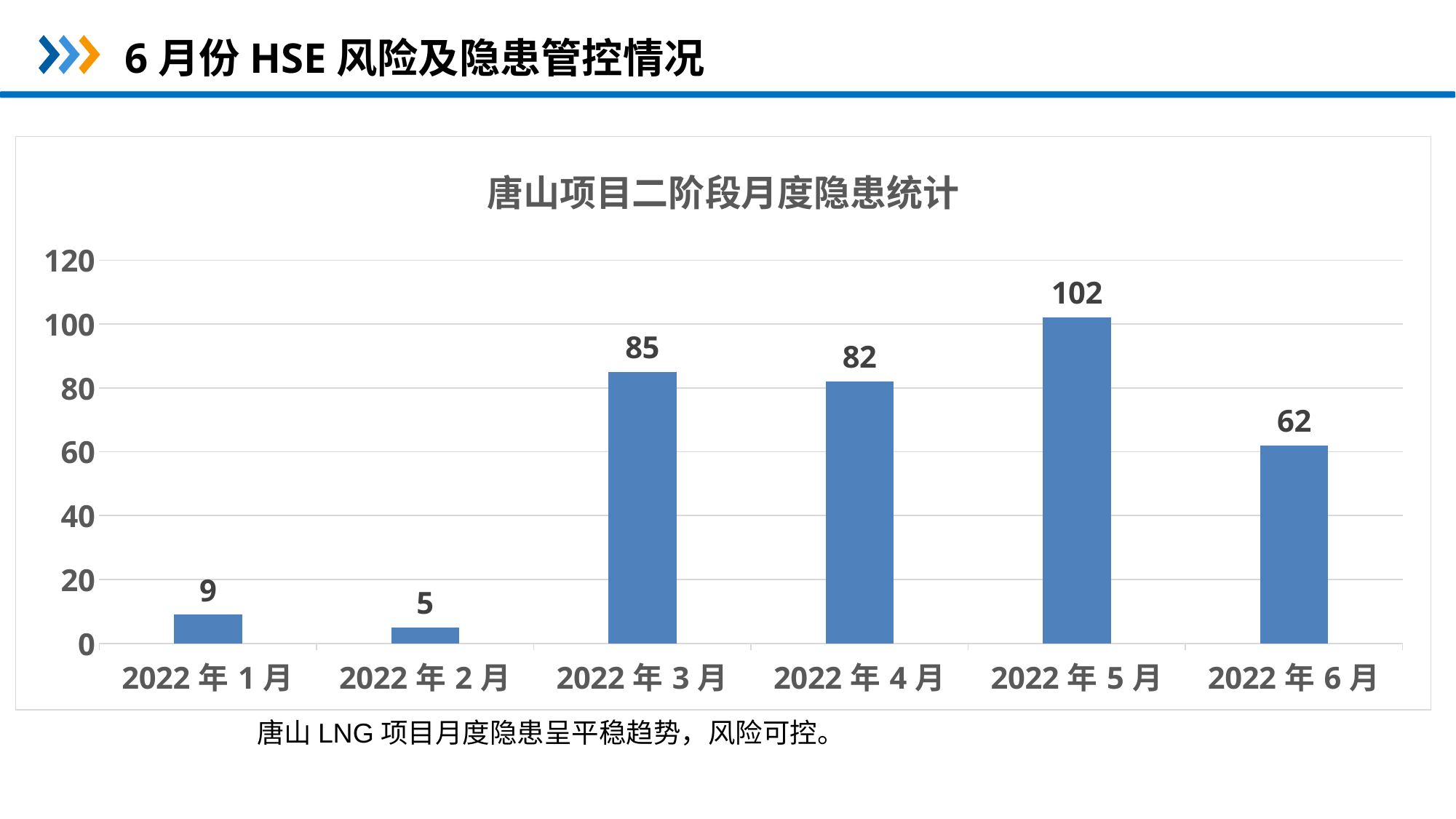
What kind of chart is shown? bar chart How many months are shown on the x axis? 6 What is the value for 2022年2月? 5 Which month has the lowest value? 2022年2月 What is the title of the chart? 唐山项目二阶段月度隐患统计 What is the value for 2022年3月? 85 What is the difference between the values for 2022年5月 and 2022年6月? 40 Is the value for 2022年5月 greater or less than 100? greater Which month has the highest value? 2022年5月 What is the value for 2022年6月? 62 Which is larger, the value for 2022年3月 or 2022年4月? 2022年3月 What is the difference between the values for 2022年1月 and 2022年2月? 4